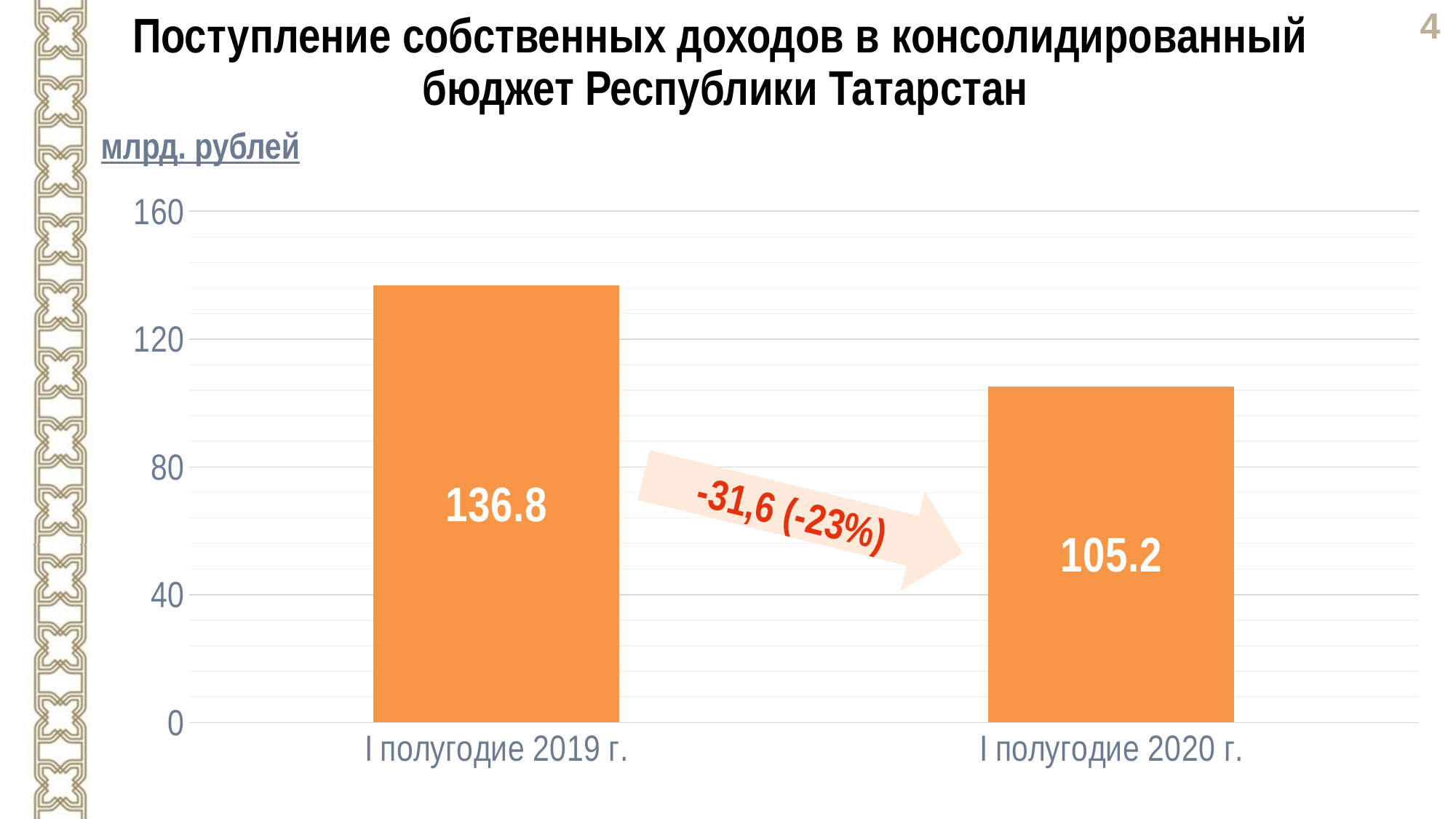
Is the value for I полугодие 2020 г. greater or less than 120? less Is the value for I полугодие 2019 г. greater or less than 120? greater What is the difference between the values for I полугодие 2019 г. and I полугодие 2020 г.? 31.6 What kind of chart is shown on the slide? bar chart How many categories are shown on the chart? 2 What is the value for I полугодие 2020 г.? 105.2 What unit of measurement is indicated above the chart? млрд. рублей Which is larger, the value for I полугодие 2019 г. or I полугодие 2020 г.? I полугодие 2019 г. What is the value for I полугодие 2019 г.? 136.8 Do the values rise or fall from I полугодие 2019 г. to I полугодие 2020 г.? fall Which category has the lowest value? I полугодие 2020 г. Which category has the highest value? I полугодие 2019 г.